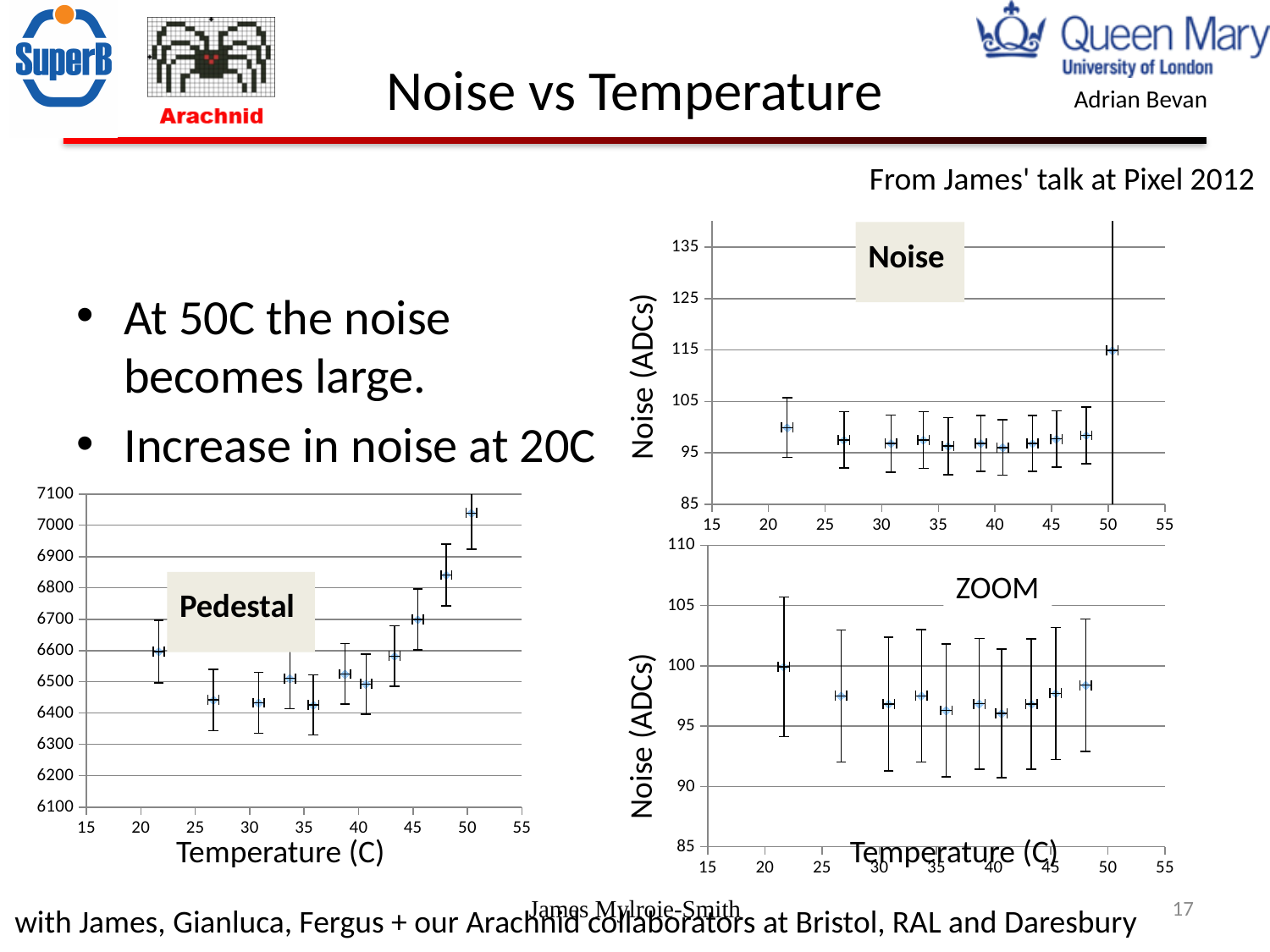
In the Pedestal chart, is the pedestal larger at about 50 C or at about 45 C? about 50 C In the Pedestal chart, do the values rise or fall as temperature increases from 35 C to 50 C? rise How many data points are plotted in the Pedestal chart? 11 What is the y-axis label of the ZOOM chart? Noise (ADCs) In the Noise chart (top right), is the noise at about 50 C greater or less than 105? greater What kind of chart is the Pedestal chart on the slide? scatter plot with error bars In the Noise chart (top right), is the noise at about 40 C greater or less than 105? less In the Pedestal chart, is the value at the lowest temperature (about 21 C) greater or less than 6500? greater How many data points are plotted in the Noise chart (top right)? 11